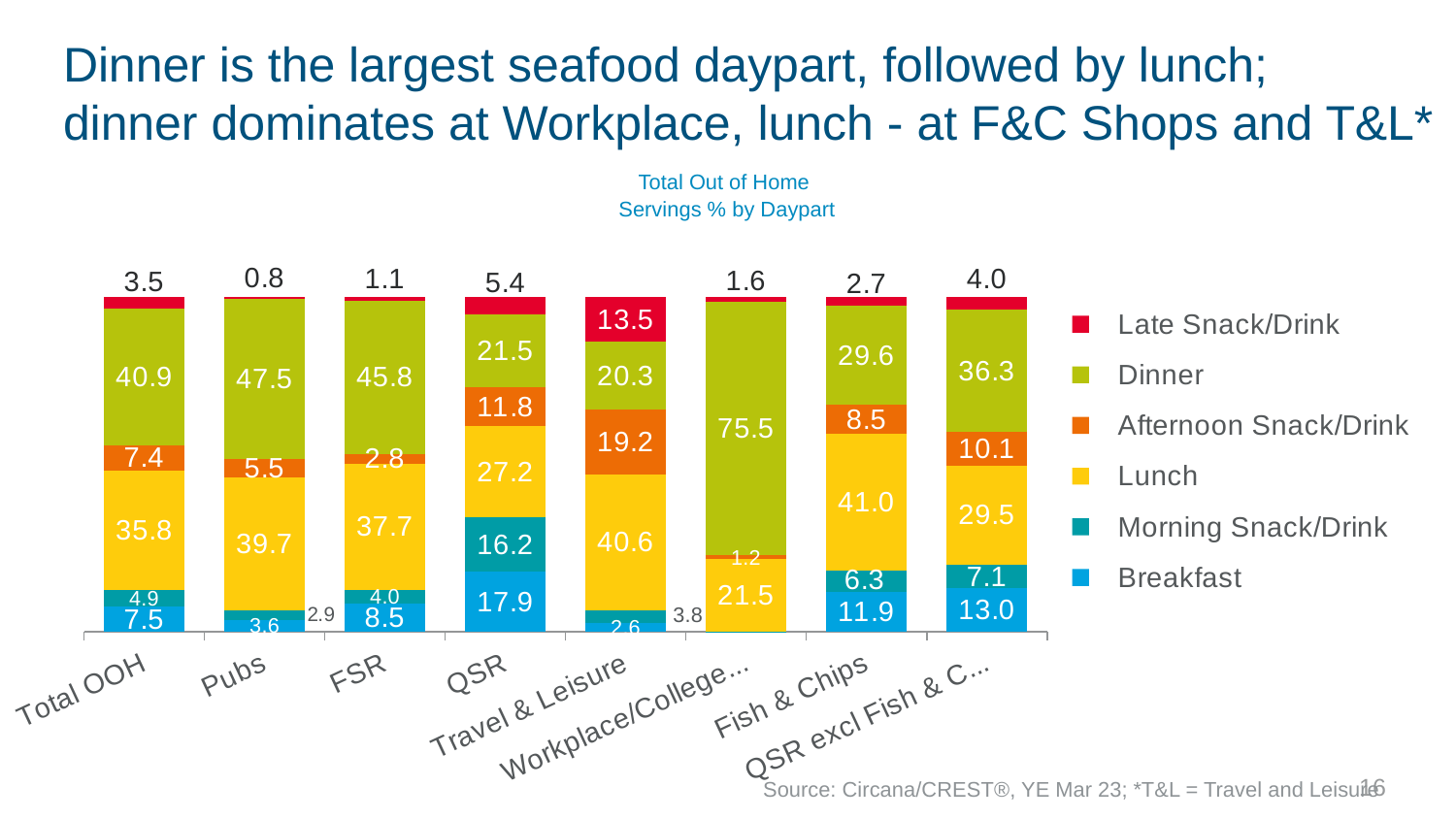
How many categories are shown on the x axis? 8 What is the Dinner value for Total OOH? 40.9 Which category has the highest Dinner value? Workplace/College... Which is larger, the Dinner value for Pubs or the Dinner value for FSR? Pubs What is the Afternoon Snack/Drink value for QSR excl Fish & C...? 10.1 How many series does the legend list? 6 Which category has the lowest Breakfast value among those with a printed Breakfast label? Travel & Leisure Which category has the highest Late Snack/Drink value? Travel & Leisure What kind of chart is shown on the slide? Stacked bar chart What is the difference between the Dinner and Lunch values for Total OOH? 5.1 What is the Lunch value for Fish & Chips? 41.0 What is the Breakfast value for QSR? 17.9